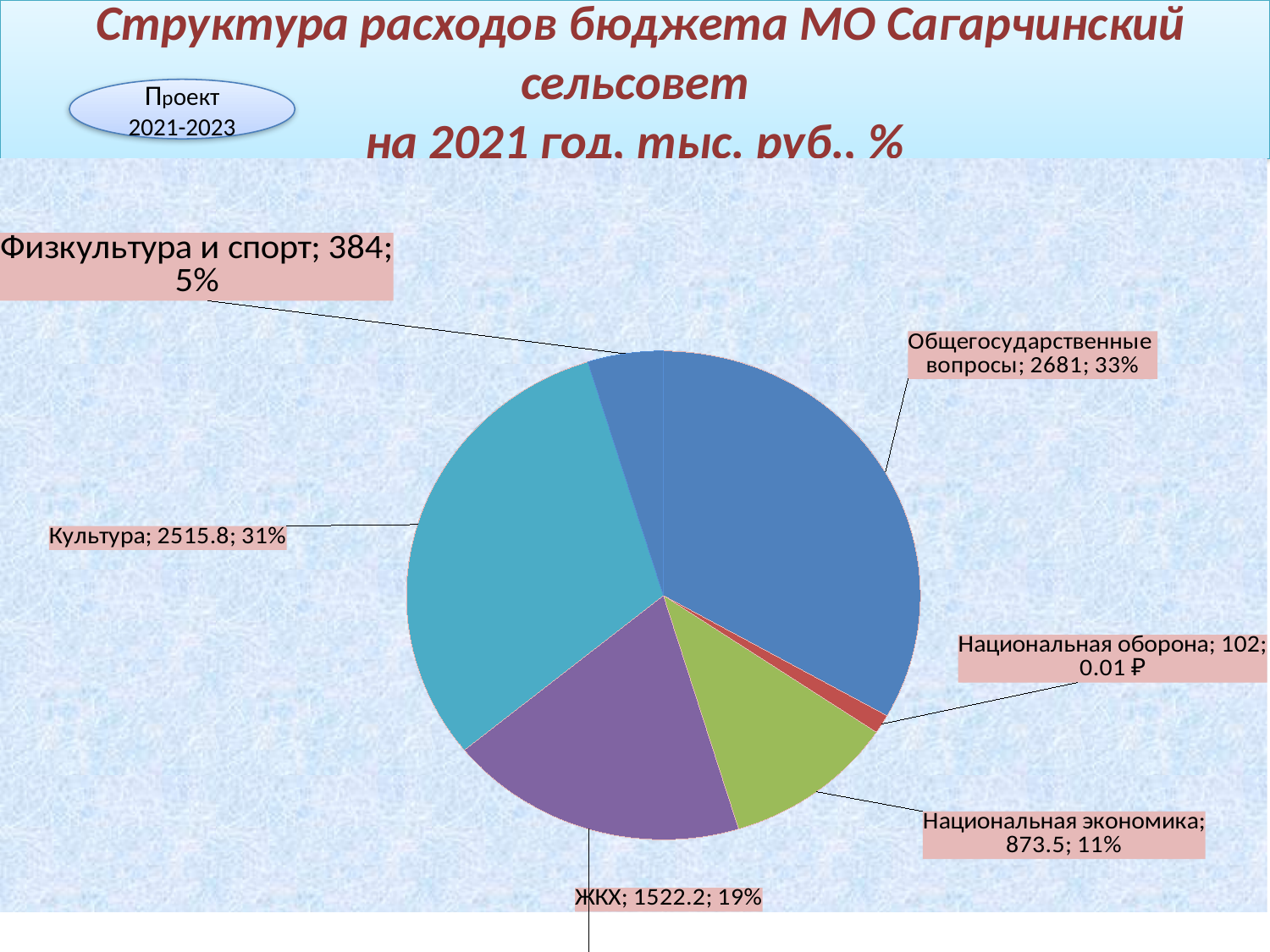
What share of the pie does Национальная экономика represent? 11% What is the value for Культура? 2515.8 Which category has the smallest slice? Национальная оборона Which category has the largest slice? Общегосударственные вопросы What is the value for Общегосударственные вопросы? 2681 What is the difference between the values for Общегосударственные вопросы and Культура? 165.2 What kind of chart is shown on the slide? pie chart Which is larger, the value for ЖКХ or the value for Национальная экономика? ЖКХ What share of the pie does Физкультура и спорт represent? 5% What is the value for ЖКХ? 1522.2 What is the value for Национальная оборона? 102 How many slices does the pie chart have? 6